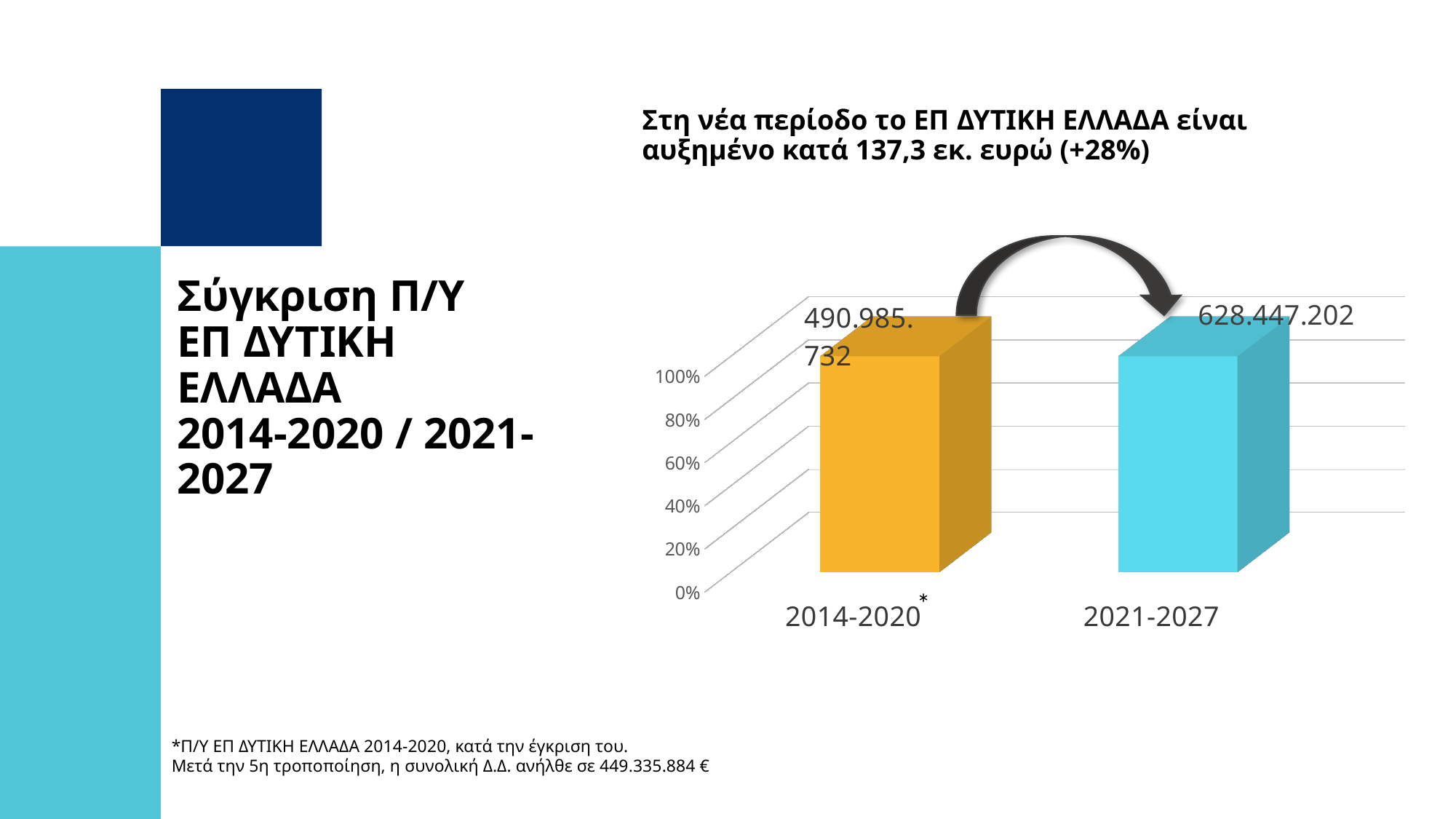
How many periods (bars) are shown in the chart? 2 Which period has the higher value? 2021-2027 What is the difference between the values for 2021-2027 and 2014-2020? 137.461.470 What colour is the bar for 2021-2027? light blue Do the values rise or fall from 2014-2020 to 2021-2027? rise What colour is the bar for 2014-2020? orange What is the value shown for 2021-2027? 628.447.202 What is the value shown for 2014-2020? 490.985.732 Is the value for 2021-2027 larger or smaller than the value for 2014-2020? larger What kind of chart is shown on the slide? bar chart Which period has the lower value? 2014-2020